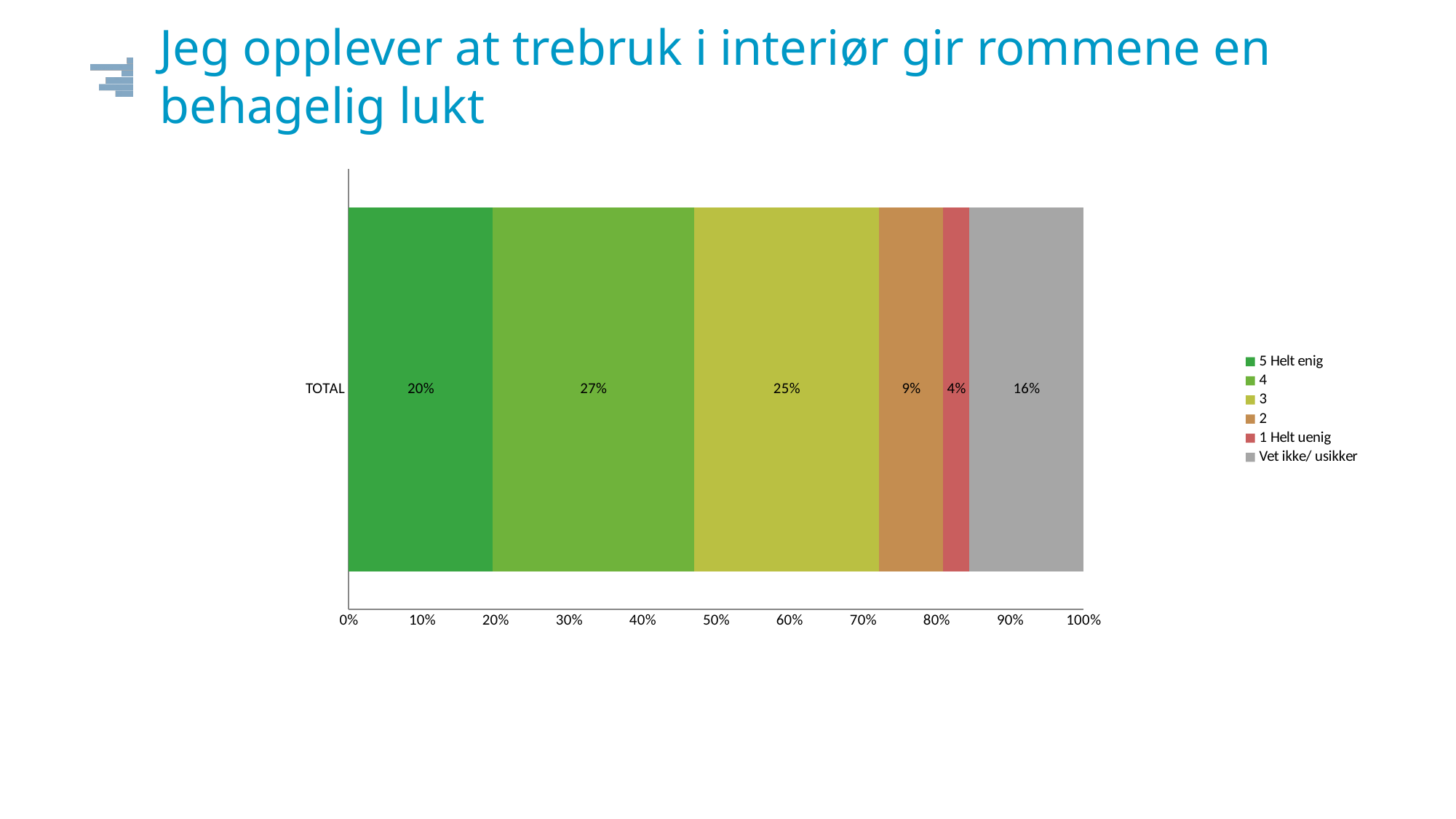
Which response category has the largest share in the TOTAL bar? 4 What is the difference between the share for '4' and the share for '5 Helt enig'? 7% What is the label of the single category on the vertical axis? TOTAL What is the combined share of '5 Helt enig' and '4'? 47% What is the value for the '4' series in the TOTAL bar? 27% What share of respondents answered 'Vet ikke/ usikker'? 16% What kind of chart is shown on the slide? Stacked bar chart How many series does the legend list? 6 What is the value for '1 Helt uenig'? 4% What percentage of respondents answered '5 Helt enig'? 20% Which is larger, the share for '3' or the share for 'Vet ikke/ usikker'? 3 Which response category has the smallest share in the TOTAL bar? 1 Helt uenig